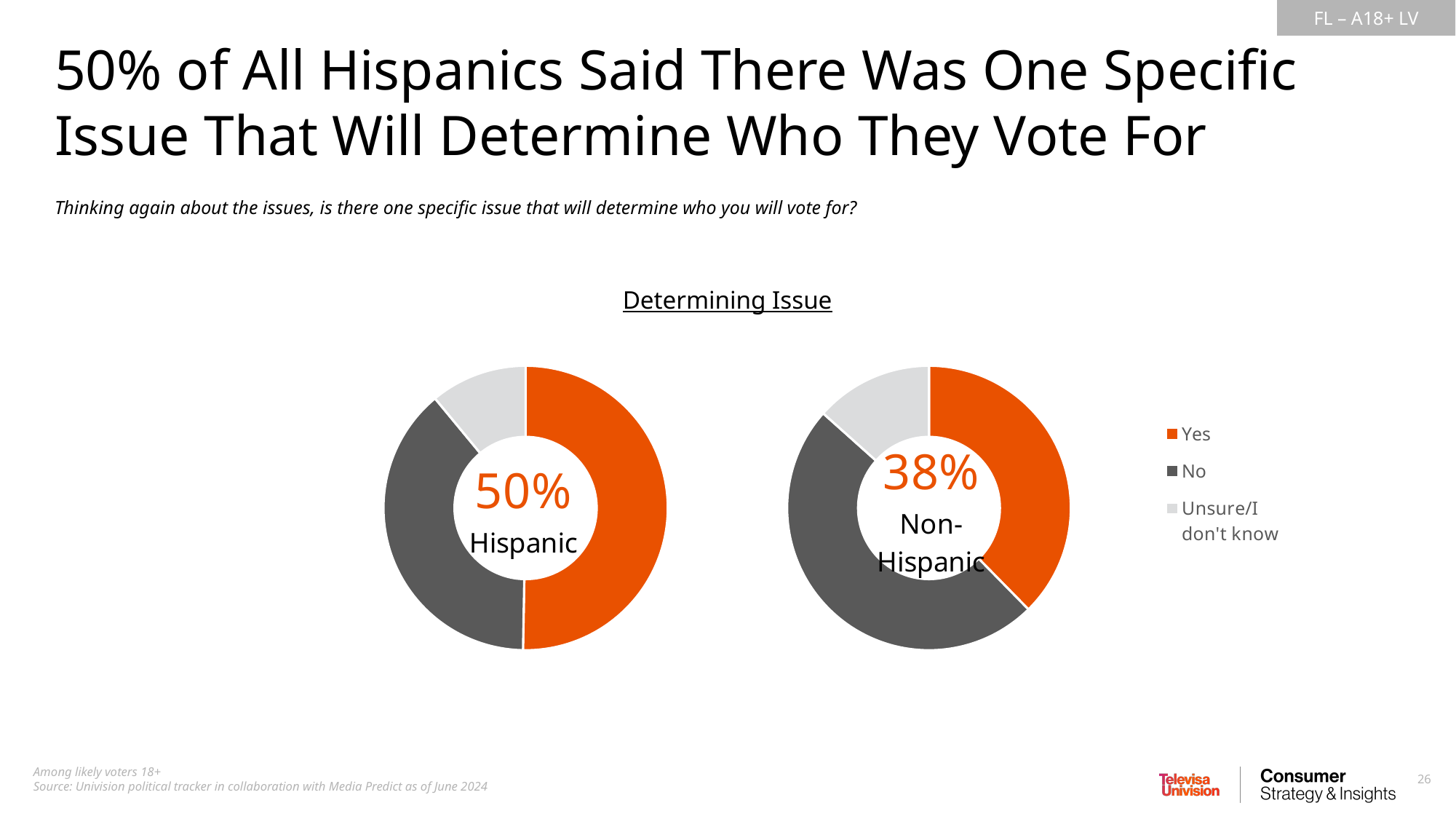
In the Non-Hispanic donut chart, what percentage said Yes? 38% What is the title shown above the two donut charts? Determining Issue In the Hispanic donut chart, what percentage said Yes? 50% Which colour represents the Yes response in the donut charts? Orange What is the difference between the Yes share for Hispanic and the Yes share for Non-Hispanic? 12 percentage points What type of chart is used to show the Determining Issue data? Donut (pie) chart In the Hispanic donut chart, which response is the smallest slice? Unsure/I don't know In the Non-Hispanic donut chart, which response is the largest slice? No In the Non-Hispanic donut chart, which response is the smallest slice? Unsure/I don't know How many response categories does the legend list? 3 In the Hispanic donut chart, which response is the largest slice? Yes Which group has the larger Yes share, Hispanic or Non-Hispanic? Hispanic